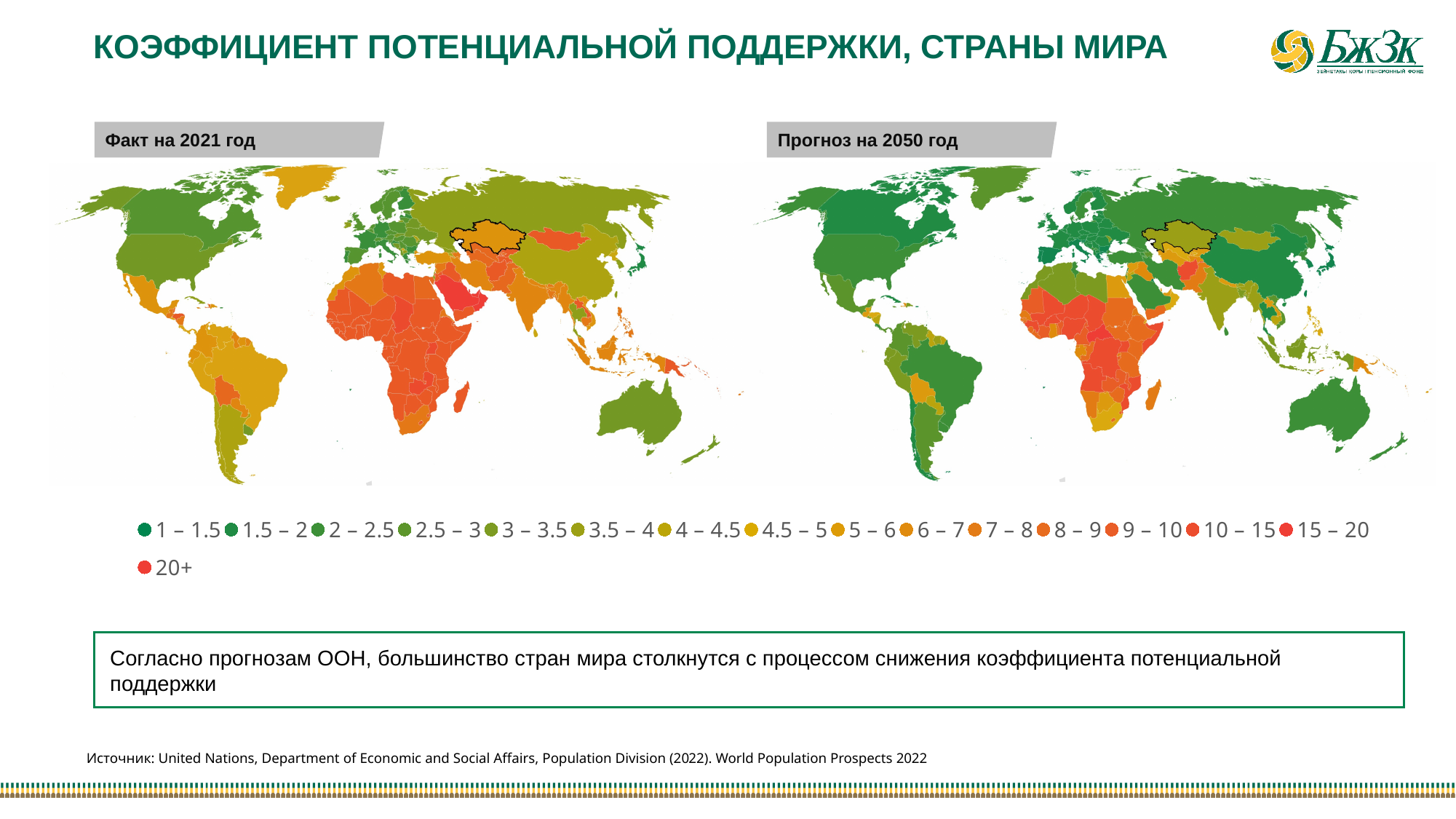
What is the lowest value range in the legend? 1 – 1.5 What is the title of the left map? Факт на 2021 год What is the highest value range in the legend? 20+ Which colour in the legend represents the range 20+? Red What kind of chart is shown on the slide? Map (choropleth world map) How many maps are shown on the slide? 2 What is the title of the right map? Прогноз на 2050 год How many value ranges does the legend list? 16 Which colour in the legend represents the range 1 – 1.5? Dark green